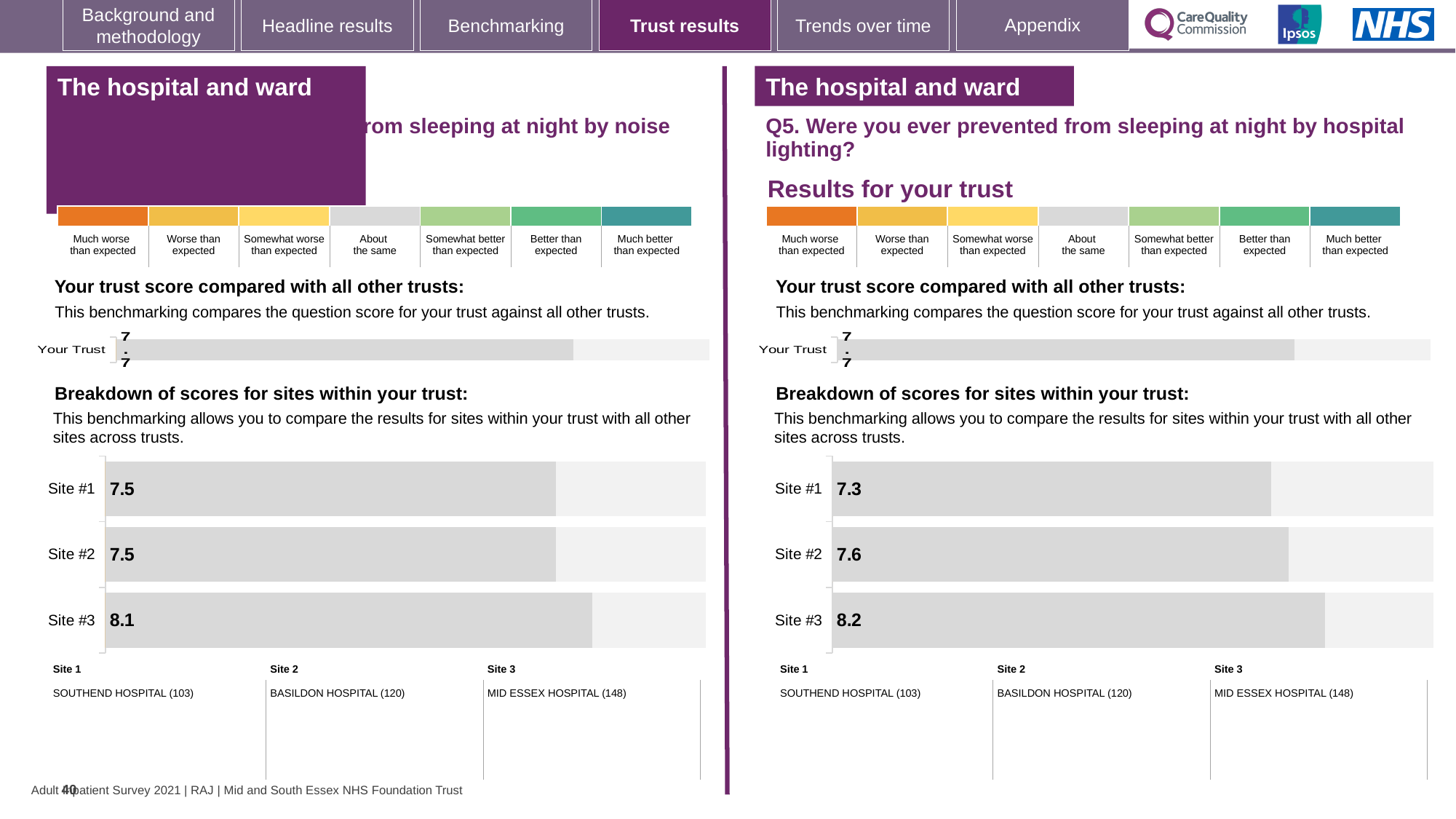
In the left-hand site breakdown chart (sleeping at night by noise), what is the difference between the scores for Site #3 and Site #2? 0.6 In the right-hand site breakdown chart (Q5, hospital lighting), what is the score for Site #2? 7.6 In the left-hand 'Breakdown of scores for sites within your trust' chart (sleeping at night by noise), what is the score for Site #3? 8.1 In the left-hand site breakdown chart (sleeping at night by noise), what is the score for Site #1? 7.5 In the right-hand site breakdown chart (Q5, hospital lighting), which site has the highest score? Site #3 In the right-hand site breakdown chart (Q5, hospital lighting), which site has the lowest score? Site #1 In the right-hand site breakdown chart (Q5, hospital lighting), what is the difference between the scores for Site #3 and Site #1? 0.9 In the right-hand site breakdown chart (Q5, hospital lighting), which is larger, the score for Site #2 or Site #1? Site #2 How many sites are shown in the left-hand site breakdown chart (sleeping at night by noise)? 3 In the right-hand site breakdown chart (Q5, hospital lighting), what is the score for Site #1? 7.3 In the left-hand site breakdown chart (sleeping at night by noise), which site has the highest score? Site #3 What kind of chart is the right-hand 'Breakdown of scores for sites within your trust' chart (Q5, hospital lighting)? Bar chart